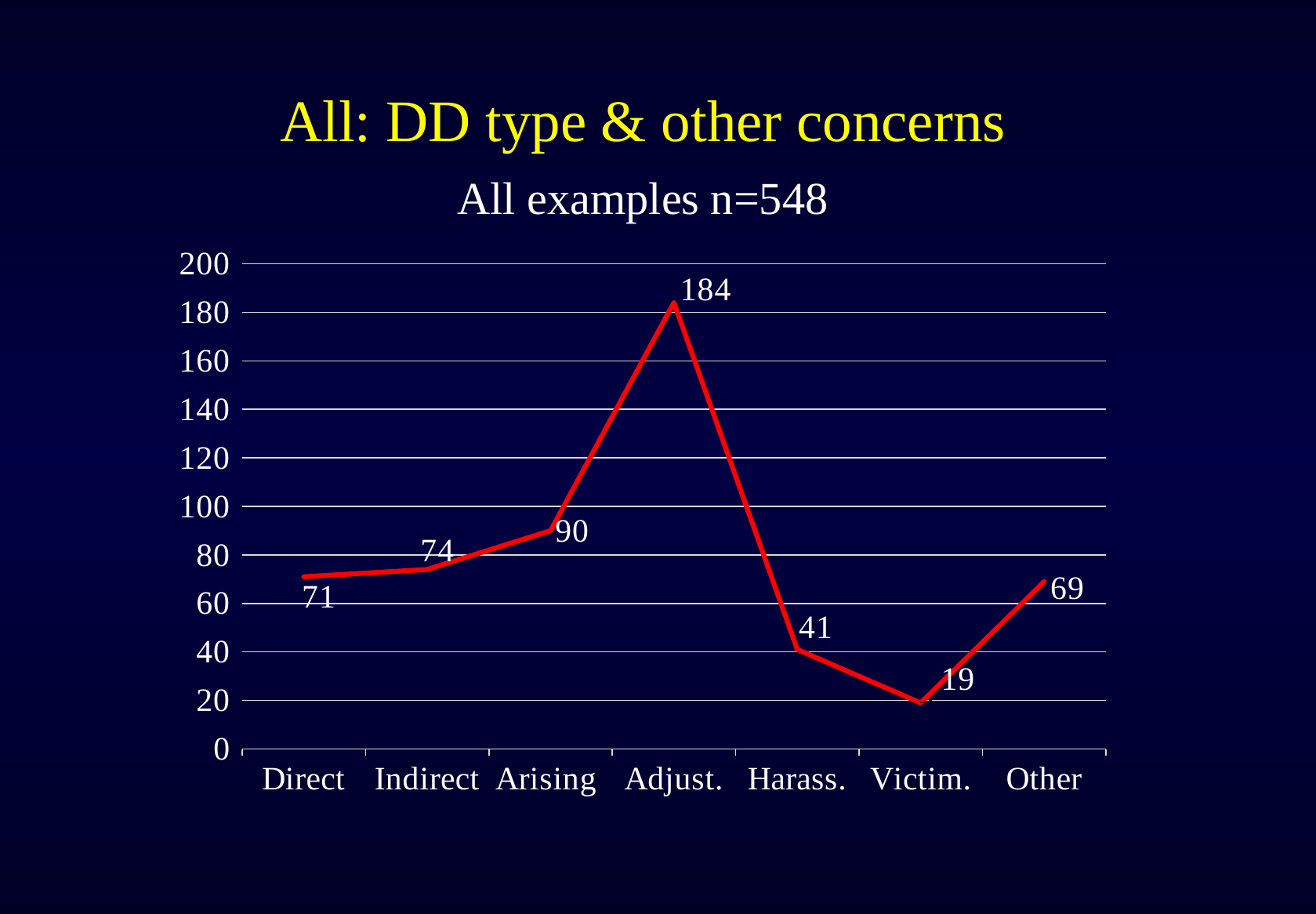
How many categories are shown on the x axis? 7 What kind of chart is this? Line chart What is the difference between the values for Harass. and Victim.? 22 What is the value for Adjust.? 184 What is the value for Other? 69 What is the value for Victim.? 19 Which category has the highest value? Adjust. Which is larger, the value for Direct or the value for Other? Direct Which category has the lowest value? Victim. What is the difference between the values for Adjust. and Arising? 94 What is the chart's subtitle below the main title? All examples n=548 What is the value for Indirect? 74